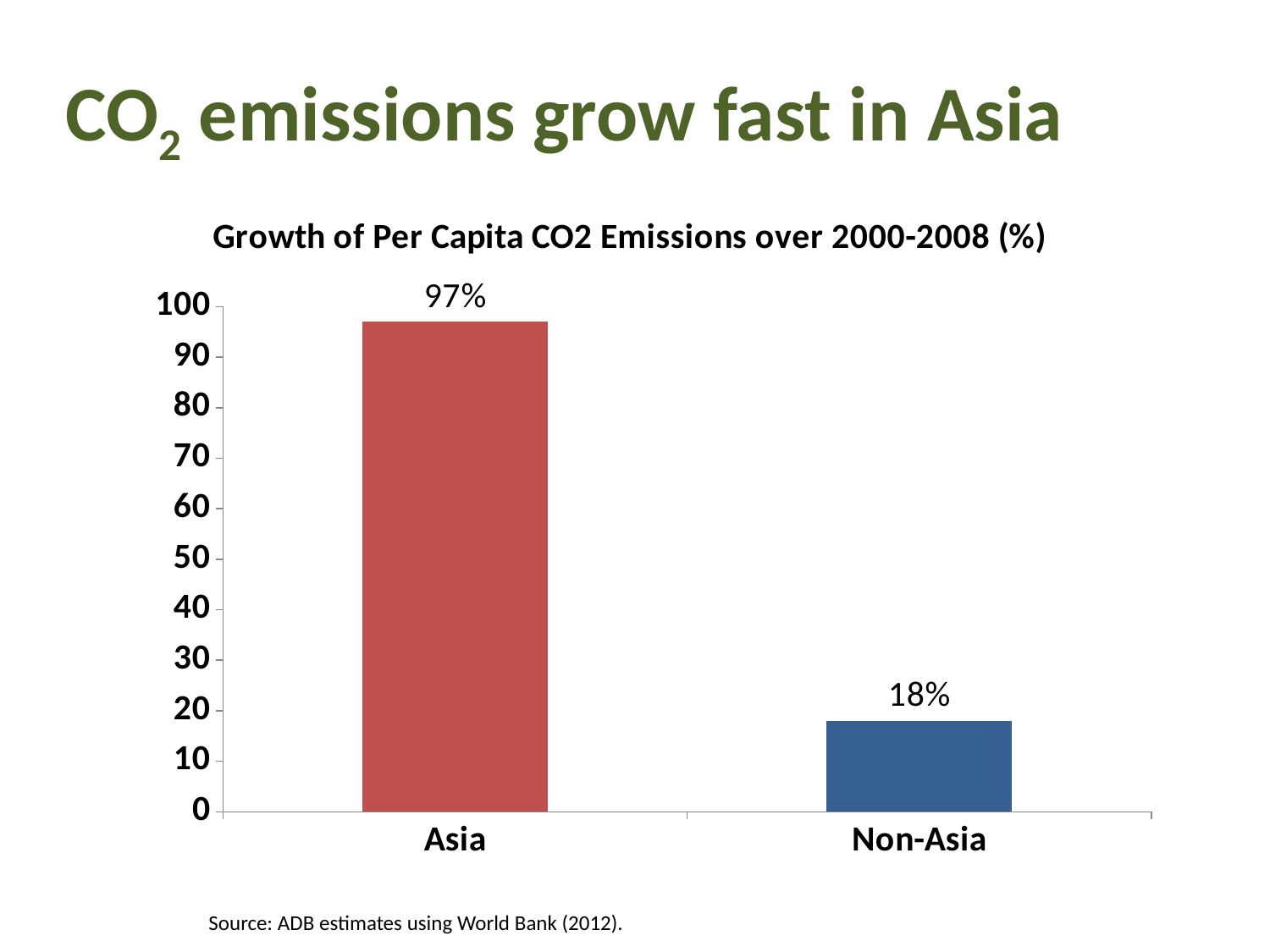
Is the value for Non-Asia greater or less than 20? less Which category has the lowest growth of per capita CO2 emissions? Non-Asia Is the value for Asia greater or less than 90? greater What kind of chart is shown on the slide? Bar chart Which category has the highest growth of per capita CO2 emissions? Asia What is the title of the chart? Growth of Per Capita CO2 Emissions over 2000-2008 (%) What is the difference in percentage points between the growth for Asia and Non-Asia? 79 What colour is the bar for Asia? Red How many categories are shown in the chart? 2 Which is larger, the growth for Asia or for Non-Asia? Asia What is the growth of per capita CO2 emissions for Non-Asia? 18% What is the growth of per capita CO2 emissions for Asia? 97%